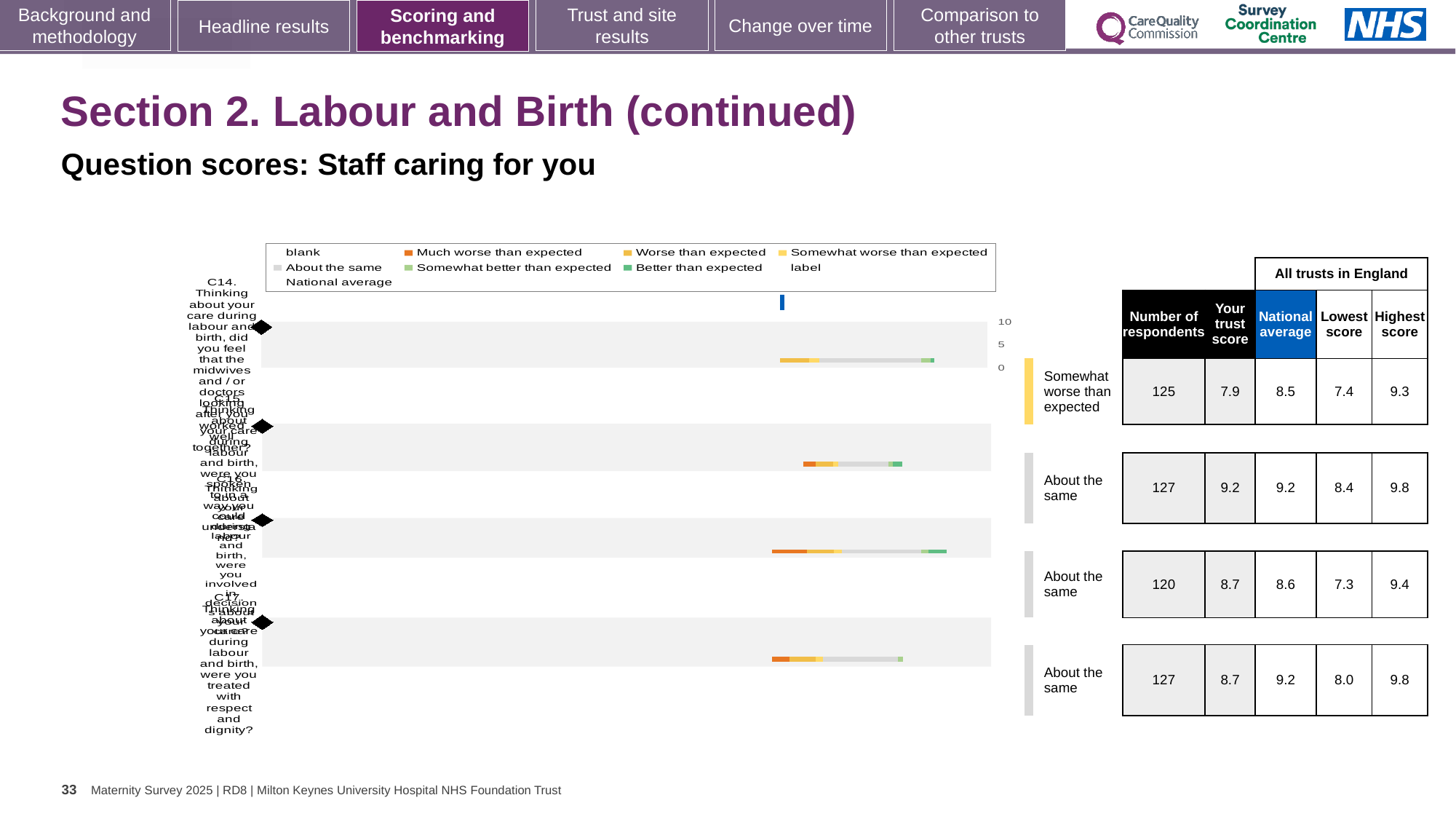
For the last (bottom) question row, C17, which is larger: the trust score or the national average? national average What is the lowest score across all trusts in England for the third question row? 7.3 How many respondents are shown for the last (bottom) question row, C17? 127 What is the benchmark category shown for the first (top) question row, C14? Somewhat worse than expected What is the difference between the highest score and the lowest score for the first (top) question row, C14? 1.9 What is the 'Your trust score' for the first (top) question row, C14? 7.9 What is the national average for the first (top) question row, C14? 8.5 Which question row has the highest 'Your trust score'? the second row (9.2) What kind of chart is shown on the slide? bar chart How many question rows (bars) does the chart show? 4 What is the subtitle describing the question scores on this slide? Question scores: Staff caring for you How many question rows are rated 'About the same'? 3